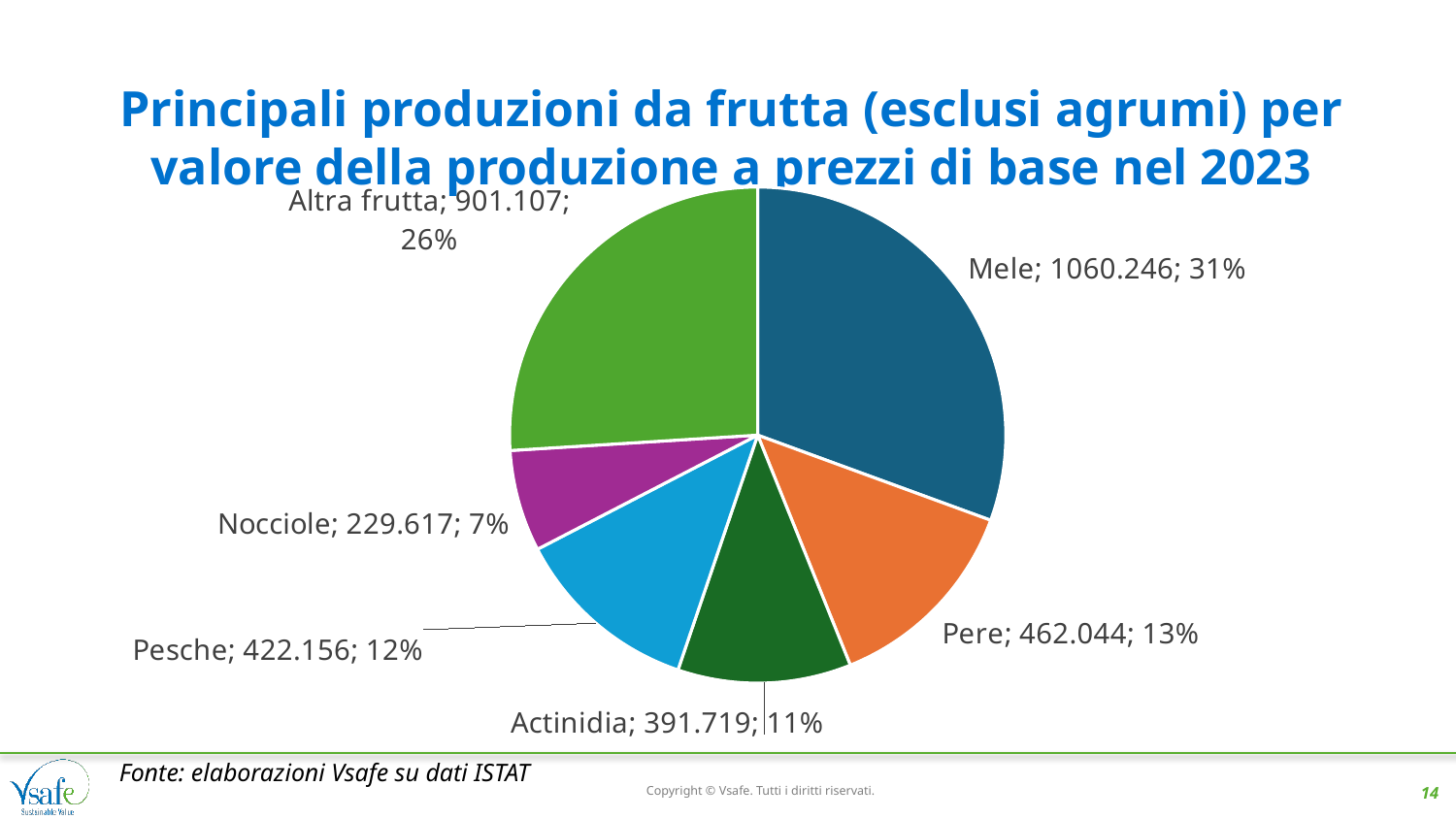
What share of the pie does Altra frutta represent? 26% Which is larger, the value for Pesche or the value for Nocciole? Pesche What is the value shown for Nocciole? 229.617 Which category has the largest slice of the pie? Mele What is the value shown for Mele? 1060.246 What kind of chart is shown on the slide? Pie chart Which category has the smallest slice of the pie? Nocciole How many categories are shown in the pie chart? 6 What is the difference between the values for Pesche and Actinidia? 30.437 What is the value shown for Actinidia? 391.719 What share of the pie does Pere represent? 13% What is the difference between the values for Mele and Pere? 598.202